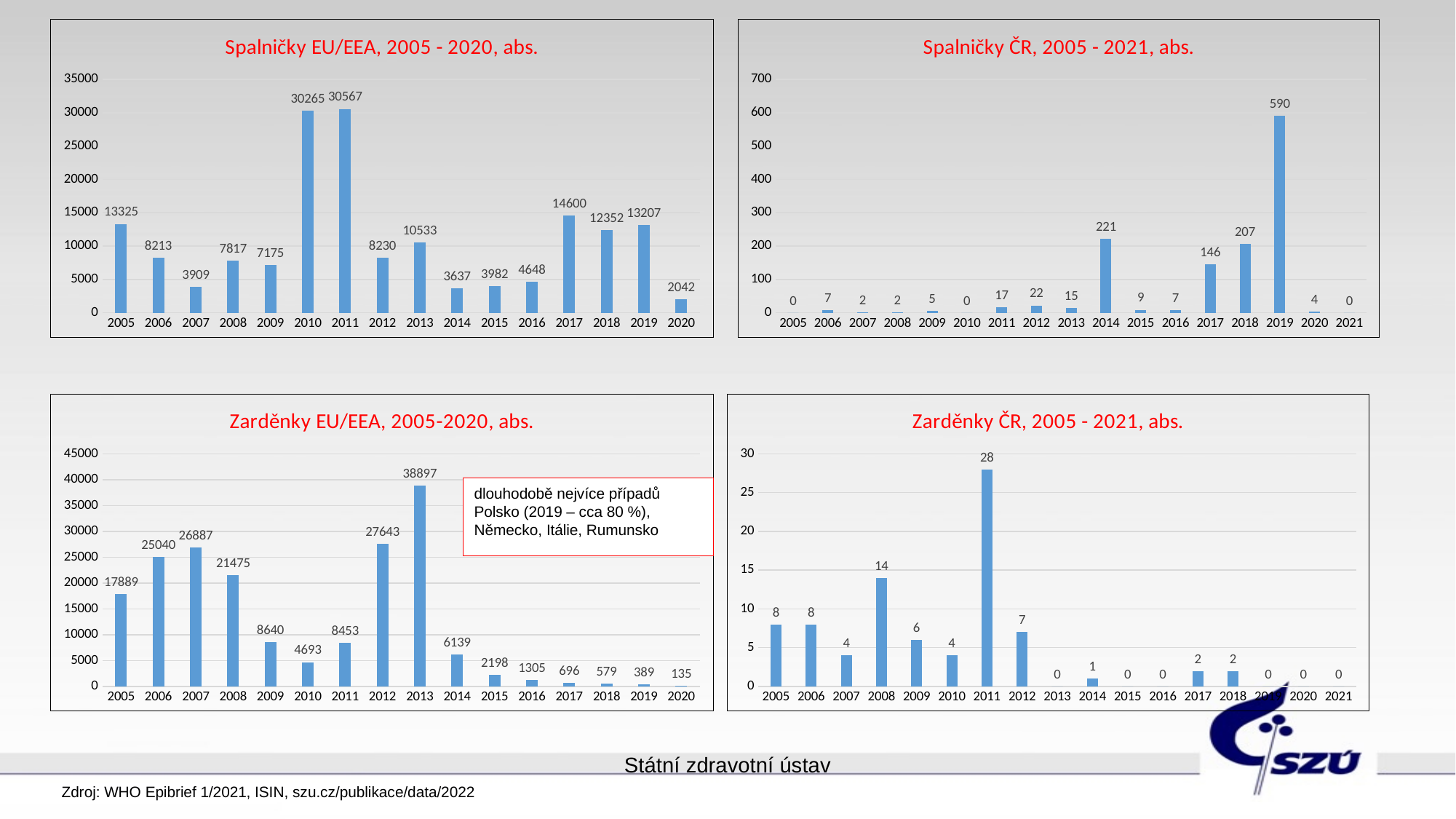
In the chart titled 'Spalničky EU/EEA, 2005 - 2020, abs.', which year has the highest value? 2011 What kind of chart is the chart titled 'Zarděnky ČR, 2005 - 2021, abs.'? bar chart In the chart titled 'Spalničky ČR, 2005 - 2021, abs.', how many years are shown on the x axis? 17 In the chart titled 'Spalničky ČR, 2005 - 2021, abs.', what is the difference between the values for 2018 and 2017? 61 In the chart titled 'Zarděnky EU/EEA, 2005-2020, abs.', what is the value for 2013? 38897 In the chart titled 'Zarděnky ČR, 2005 - 2021, abs.', which year has the highest value? 2011 In the chart titled 'Zarděnky EU/EEA, 2005-2020, abs.', do the values rise or fall from 2013 to 2020? fall In the chart titled 'Spalničky EU/EEA, 2005 - 2020, abs.', what is the value for 2010? 30265 In the chart titled 'Spalničky ČR, 2005 - 2021, abs.', what is the value for 2019? 590 In the chart titled 'Zarděnky ČR, 2005 - 2021, abs.', what is the value for 2008? 14 In the chart titled 'Spalničky EU/EEA, 2005 - 2020, abs.', which year has the lowest value? 2020 In the chart titled 'Zarděnky EU/EEA, 2005-2020, abs.', which is larger, the value for 2007 or the value for 2012? 2012